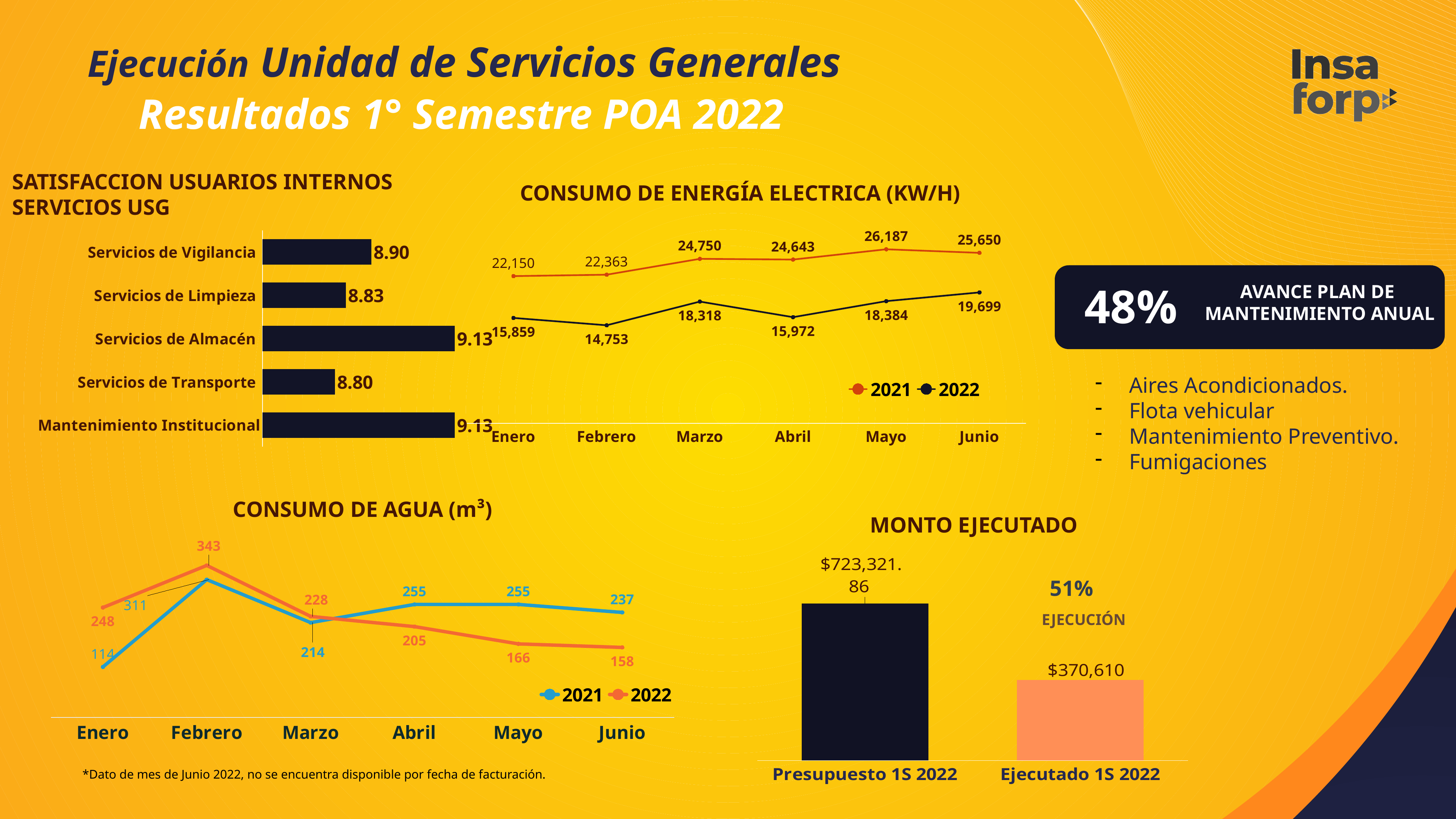
In the MONTO EJECUTADO chart, what is the value for Ejecutado 1S 2022? $370,610 In the CONSUMO DE ENERGÍA ELECTRICA (KW/H) chart, what is the 2022 value for Marzo? 18,318 What kind of chart is the SATISFACCION USUARIOS INTERNOS SERVICIOS USG chart? Bar chart In the CONSUMO DE ENERGÍA ELECTRICA (KW/H) chart, what is the difference between the 2021 and 2022 values for Junio? 5,951 In the CONSUMO DE ENERGÍA ELECTRICA (KW/H) chart, in which month is the 2021 value highest? Mayo How many categories are shown in the SATISFACCION USUARIOS INTERNOS SERVICIOS USG chart? 5 In the CONSUMO DE AGUA (m³) chart, what is the 2022 value for Febrero? 343 In the CONSUMO DE AGUA (m³) chart, does the 2022 series rise or fall from Febrero to Junio? Fall In the SATISFACCION USUARIOS INTERNOS SERVICIOS USG chart, which category has the lowest value? Servicios de Transporte In the SATISFACCION USUARIOS INTERNOS SERVICIOS USG chart, what is the value for Servicios de Limpieza? 8.83 How many series does the legend of the CONSUMO DE ENERGÍA ELECTRICA (KW/H) chart list? 2 In the CONSUMO DE AGUA (m³) chart, which is larger for Abril, the 2021 value or the 2022 value? 2021